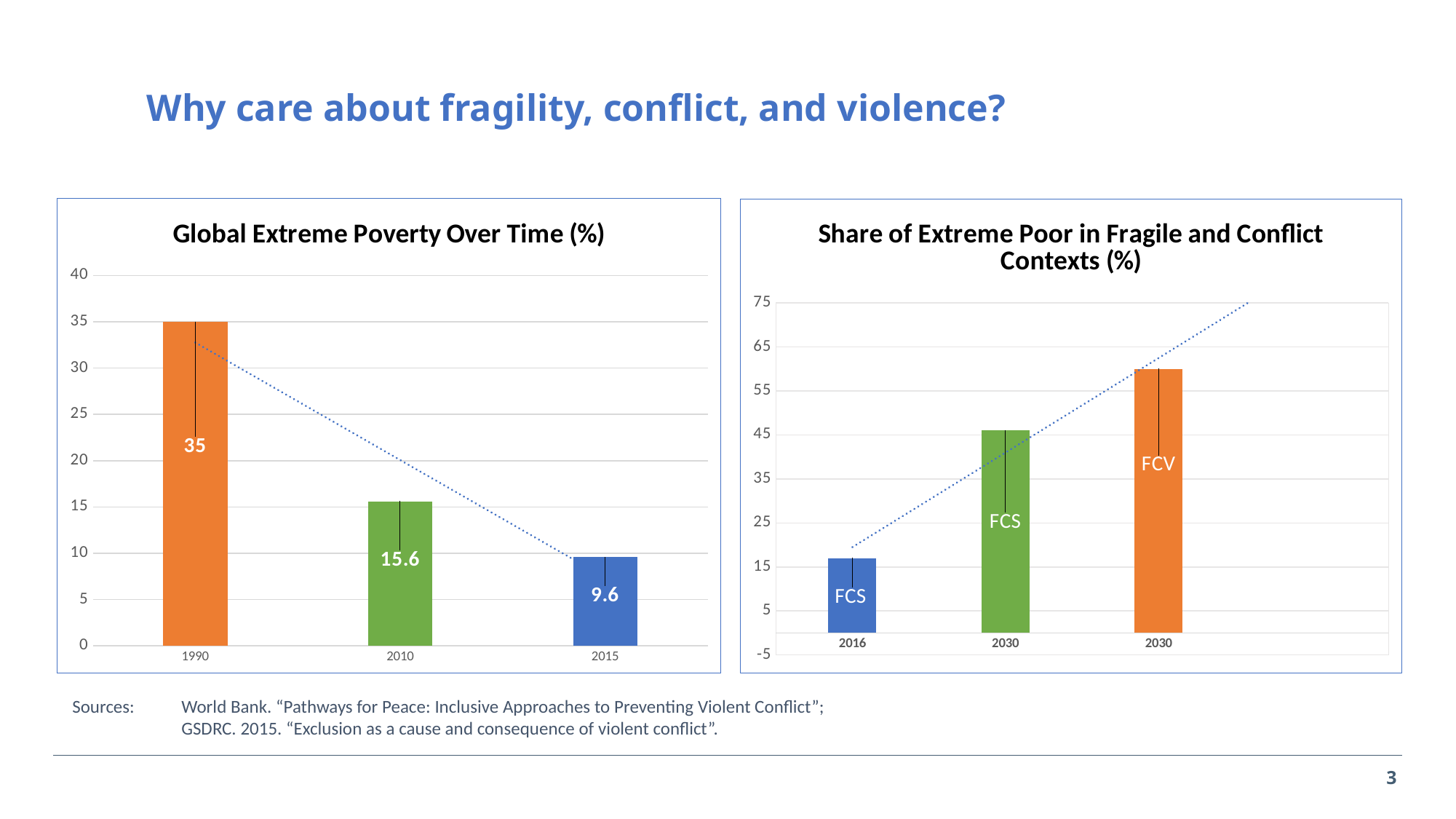
In the 'Global Extreme Poverty Over Time (%)' chart, what is the value for 2010? 15.6 In the 'Global Extreme Poverty Over Time (%)' chart, what is the value for 1990? 35 In the 'Share of Extreme Poor in Fragile and Conflict Contexts (%)' chart, is the value for FCV in 2030 greater or less than 45? greater In the 'Share of Extreme Poor in Fragile and Conflict Contexts (%)' chart, is the value for FCS in 2016 greater or less than 25? less In the 'Global Extreme Poverty Over Time (%)' chart, what is the difference between the 1990 and 2015 values? 25.4 In the 'Global Extreme Poverty Over Time (%)' chart, what is the value for 2015? 9.6 In the 'Global Extreme Poverty Over Time (%)' chart, how many years are shown? 3 In the 'Share of Extreme Poor in Fragile and Conflict Contexts (%)' chart, which bar is the tallest? FCV 2030 In the 'Global Extreme Poverty Over Time (%)' chart, do the values rise or fall from 1990 to 2015? fall In the 'Global Extreme Poverty Over Time (%)' chart, which year has the highest value? 1990 In the 'Global Extreme Poverty Over Time (%)' chart, which year has the lowest value? 2015 What kind of chart is the 'Share of Extreme Poor in Fragile and Conflict Contexts (%)' chart? bar chart